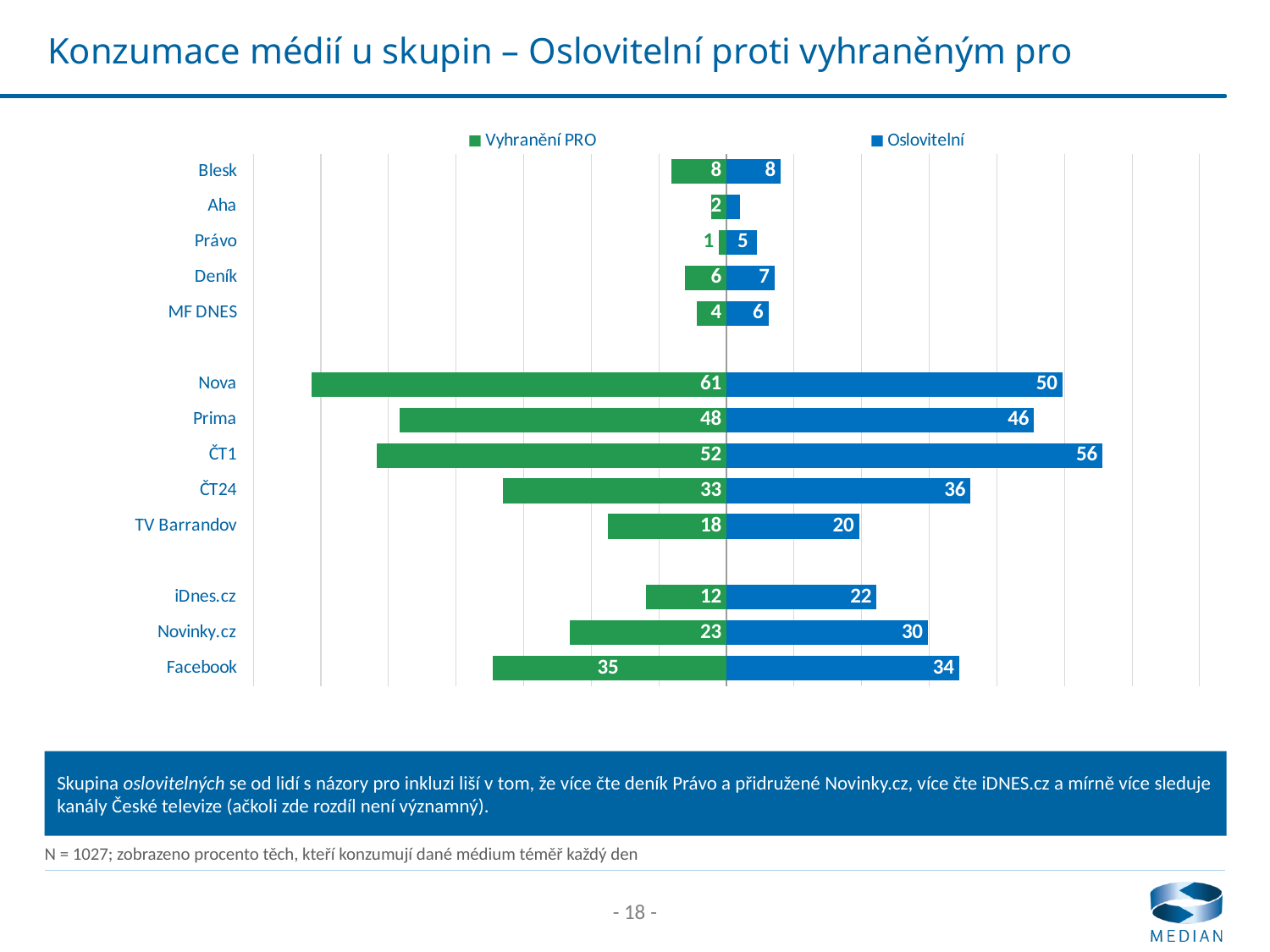
Which category has the highest Vyhranění PRO value? Nova How many categories are shown on the chart? 13 What is the Vyhranění PRO value for Nova? 61 What is the difference between the Oslovitelní and Vyhranění PRO values for iDnes.cz? 10 What kind of chart is shown on the slide? Bar chart Which category has the lowest Vyhranění PRO value? Právo What is the Oslovitelní value for iDnes.cz? 22 Which category has the highest Oslovitelní value? ČT1 How many series does the legend list? 2 Which is larger for Novinky.cz: the Vyhranění PRO value or the Oslovitelní value? Oslovitelní What is the Oslovitelní value for ČT1? 56 What is the Vyhranění PRO value for Facebook? 35